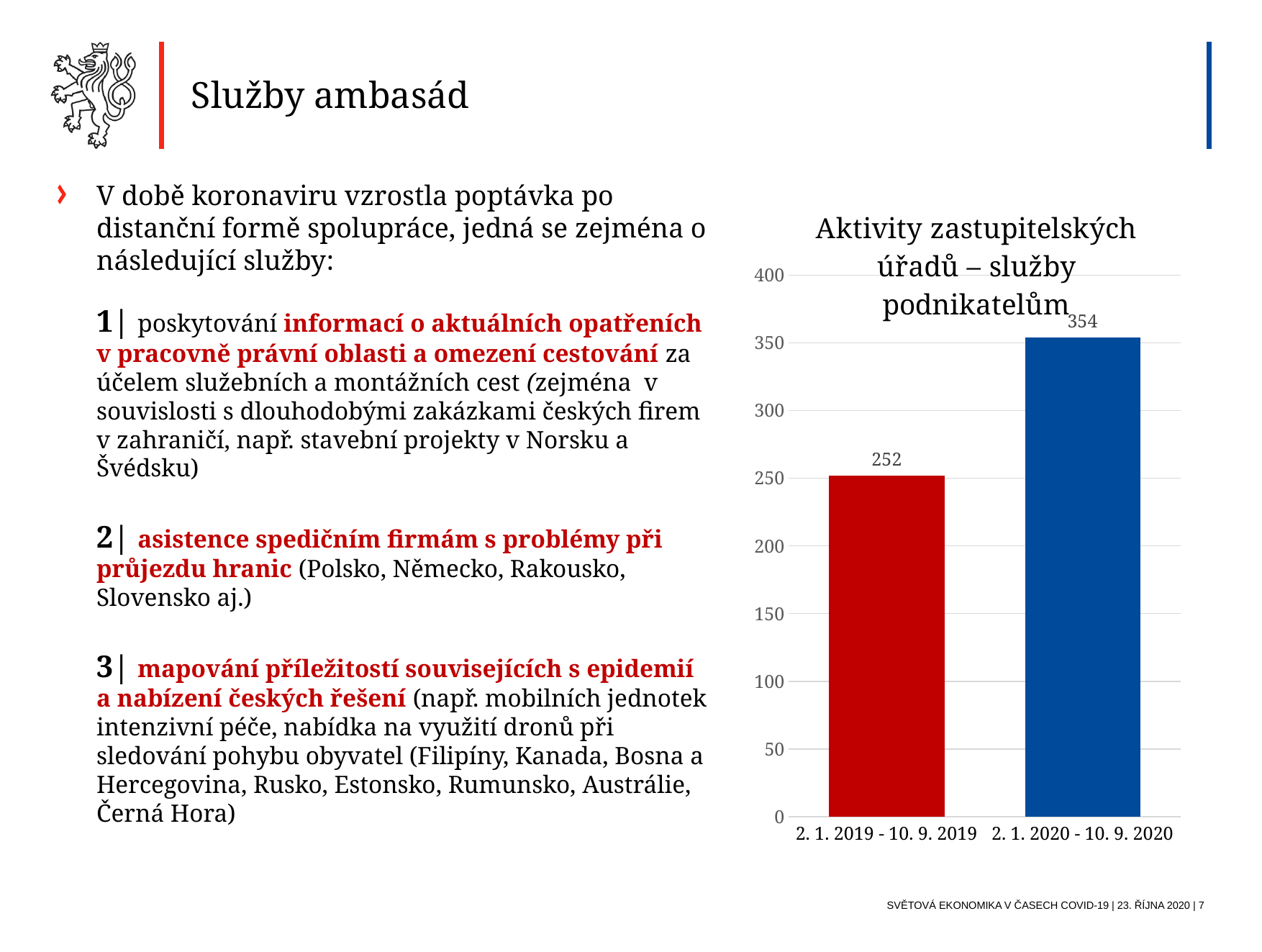
Is the value for 2. 1. 2020 - 10. 9. 2020 greater or less than 300? greater What is the value for the period 2. 1. 2020 - 10. 9. 2020? 354 Is the value for 2. 1. 2019 - 10. 9. 2019 greater or less than 300? less What kind of chart is shown on the slide? bar chart Do the values rise or fall from the 2019 period to the 2020 period? rise How many categories (periods) are shown in the chart? 2 Is the value for 2. 1. 2019 - 10. 9. 2019 larger or smaller than the value for 2. 1. 2020 - 10. 9. 2020? smaller Which period has the lower value? 2. 1. 2019 - 10. 9. 2019 What is the value for the period 2. 1. 2019 - 10. 9. 2019? 252 Which period has the higher value? 2. 1. 2020 - 10. 9. 2020 What is the title of the chart? Aktivity zastupitelských úřadů – služby podnikatelům What is the difference between the values for 2. 1. 2020 - 10. 9. 2020 and 2. 1. 2019 - 10. 9. 2019? 102